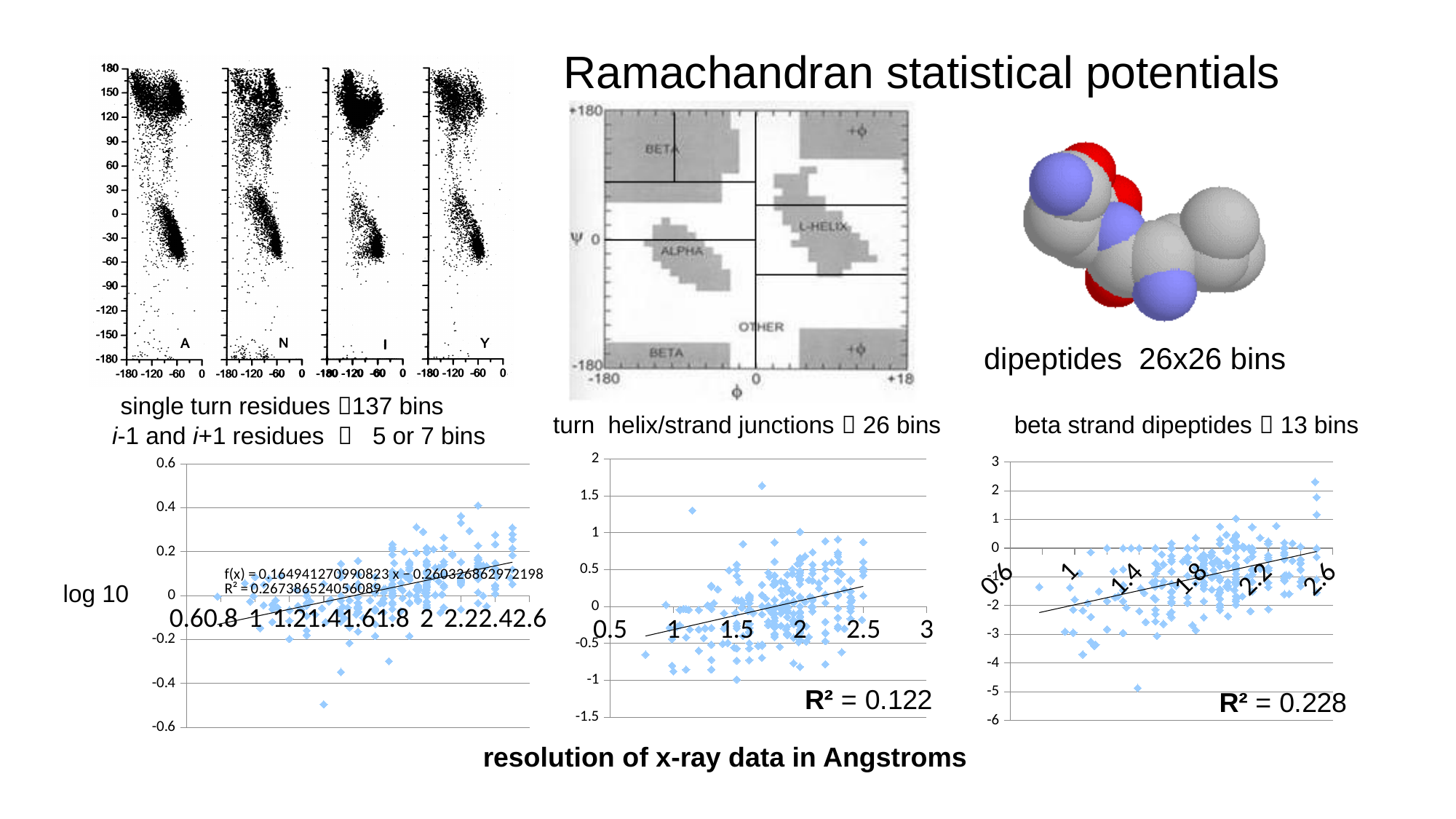
What kind of chart is the bottom-left chart on the slide? scatter chart In the bottom-right chart, what R² value is printed? 0.228 What is the x-axis label shared by the three bottom charts? resolution of x-ray data in Angstroms What is the difference between the R² value printed on the bottom-right chart and the R² value printed on the bottom-middle chart? 0.106 What kind of chart is the bottom-middle chart on the slide? scatter chart In the bottom-middle chart, does the trendline rise or fall as the x value increases? rises In the bottom-left chart, what R² value is printed next to the trendline equation? 0.267386524056089 In the bottom-right chart, does the trendline rise or fall as the x value increases? rises In the bottom-middle chart, what R² value is printed? 0.122 In the bottom-left chart, what is the slope of the trendline equation f(x) shown? 0.164941270990823 What is the maximum value shown on the y axis of the bottom-right chart? 3 Which chart has the larger printed R² value, the bottom-middle chart or the bottom-right chart? bottom-right chart